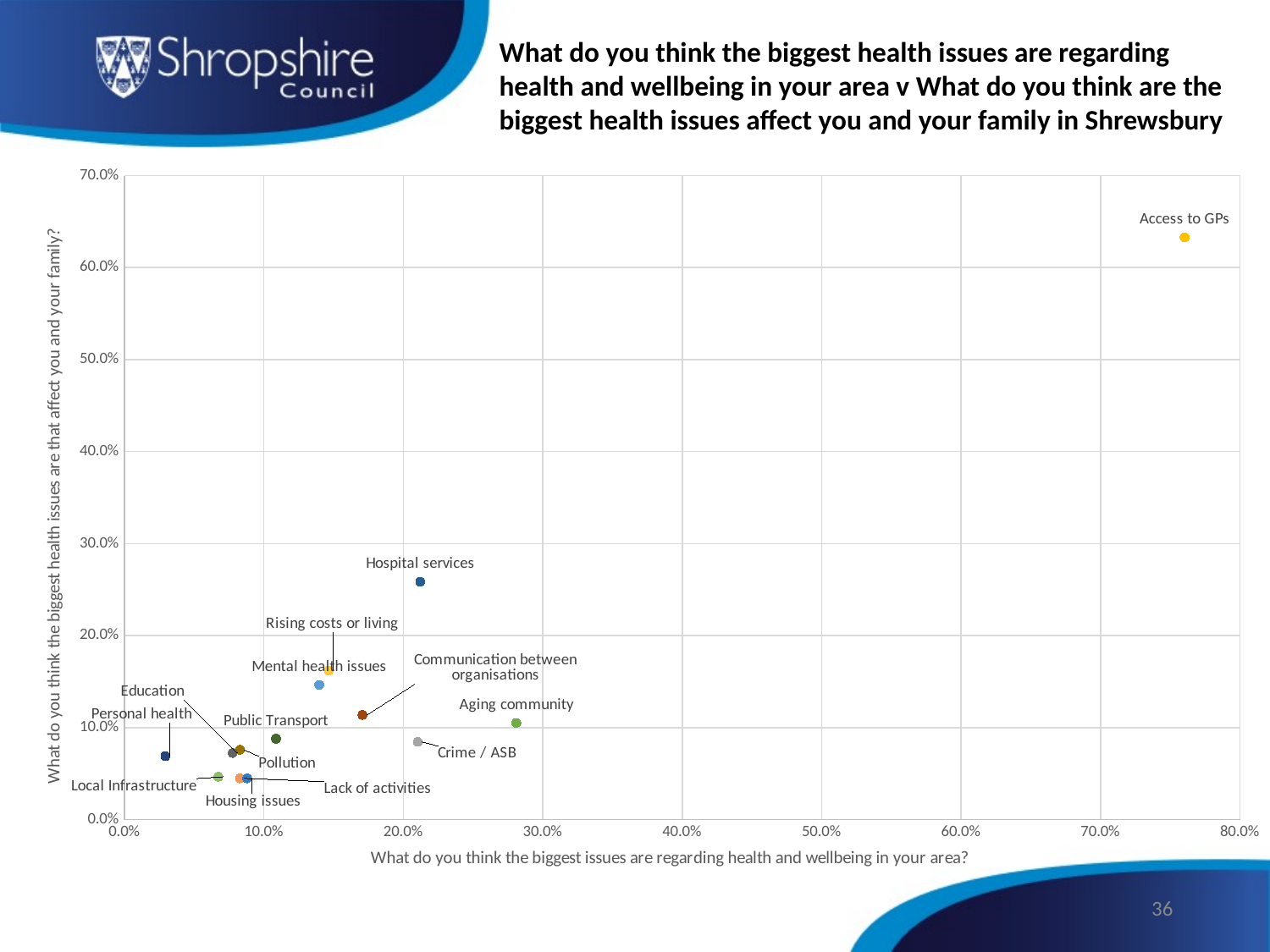
Is the horizontal-axis value for Access to GPs greater or less than 70.0%? greater What kind of chart is shown on the slide? Scatter chart Is the vertical-axis value for Hospital services greater or less than 30.0%? less Is the horizontal-axis value for Aging community greater or less than 20.0%? greater Which labelled point has the highest value on the vertical axis (issues affecting you and your family)? Access to GPs How many labelled data points are plotted on the chart? 14 Which has the higher vertical-axis value, Hospital services or Aging community? Hospital services Which labelled point has the lowest value on the horizontal axis (issues regarding health and wellbeing in your area)? Personal health Which has the higher horizontal-axis value, Access to GPs or Hospital services? Access to GPs What is the title of the horizontal axis? What do you think the biggest issues are regarding health and wellbeing in your area?